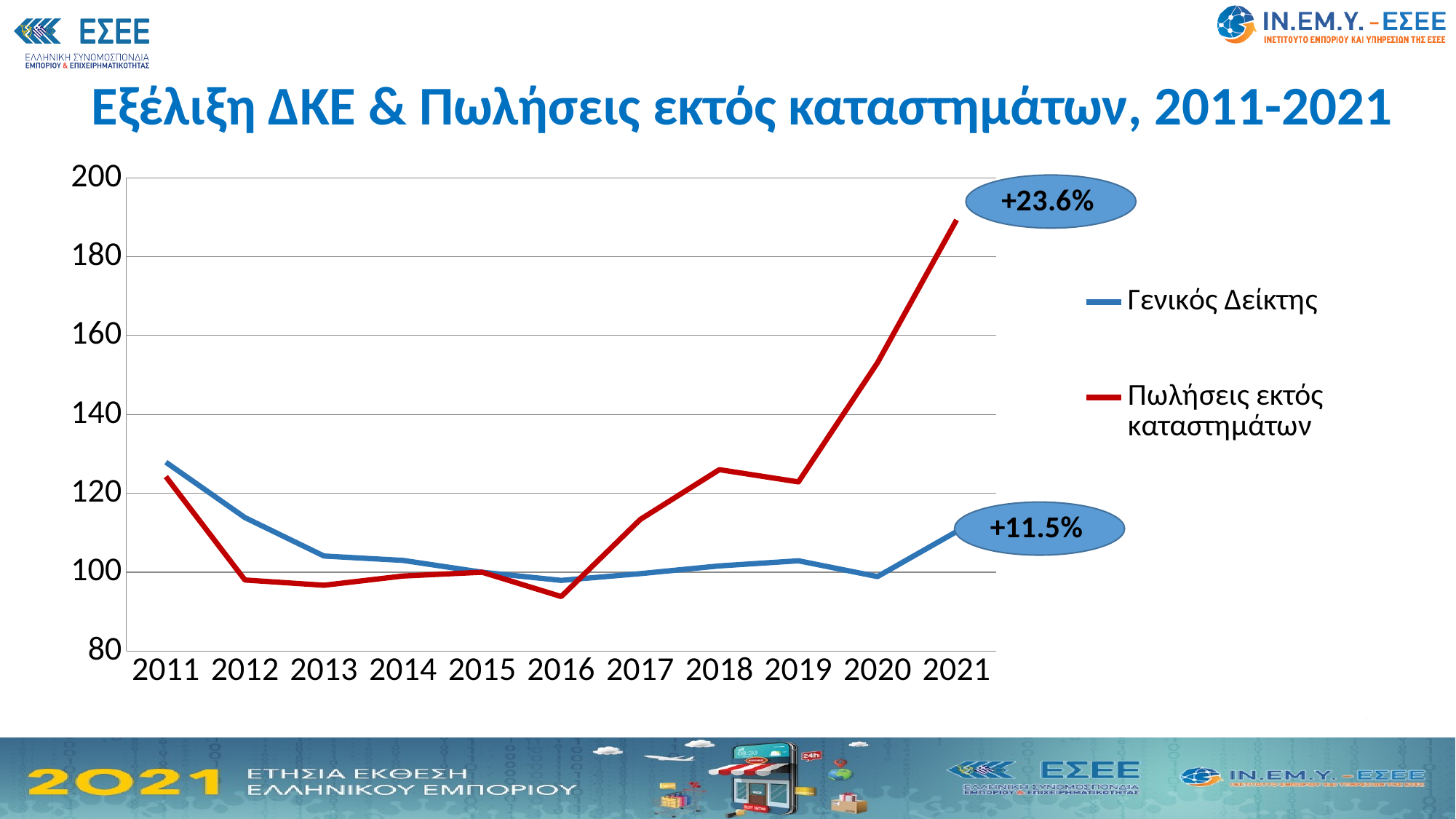
In which year does Πωλήσεις εκτός καταστημάτων reach its lowest value? 2016 How many years are shown on the x axis? 11 Does the Πωλήσεις εκτός καταστημάτων line rise or fall from 2016 to 2021? rise Is the value for Πωλήσεις εκτός καταστημάτων in 2021 greater or less than 180? greater In 2021, which series has the higher value, Γενικός Δείκτης or Πωλήσεις εκτός καταστημάτων? Πωλήσεις εκτός καταστημάτων In which year does Πωλήσεις εκτός καταστημάτων reach its highest value? 2021 What kind of chart is shown on the slide? line chart What percentage change is annotated next to the end of the red Πωλήσεις εκτός καταστημάτων line? +23.6% Is the value for Πωλήσεις εκτός καταστημάτων in 2016 greater or less than 100? less Is the value for Γενικός Δείκτης in 2011 greater or less than 120? greater How many series does the legend list? 2